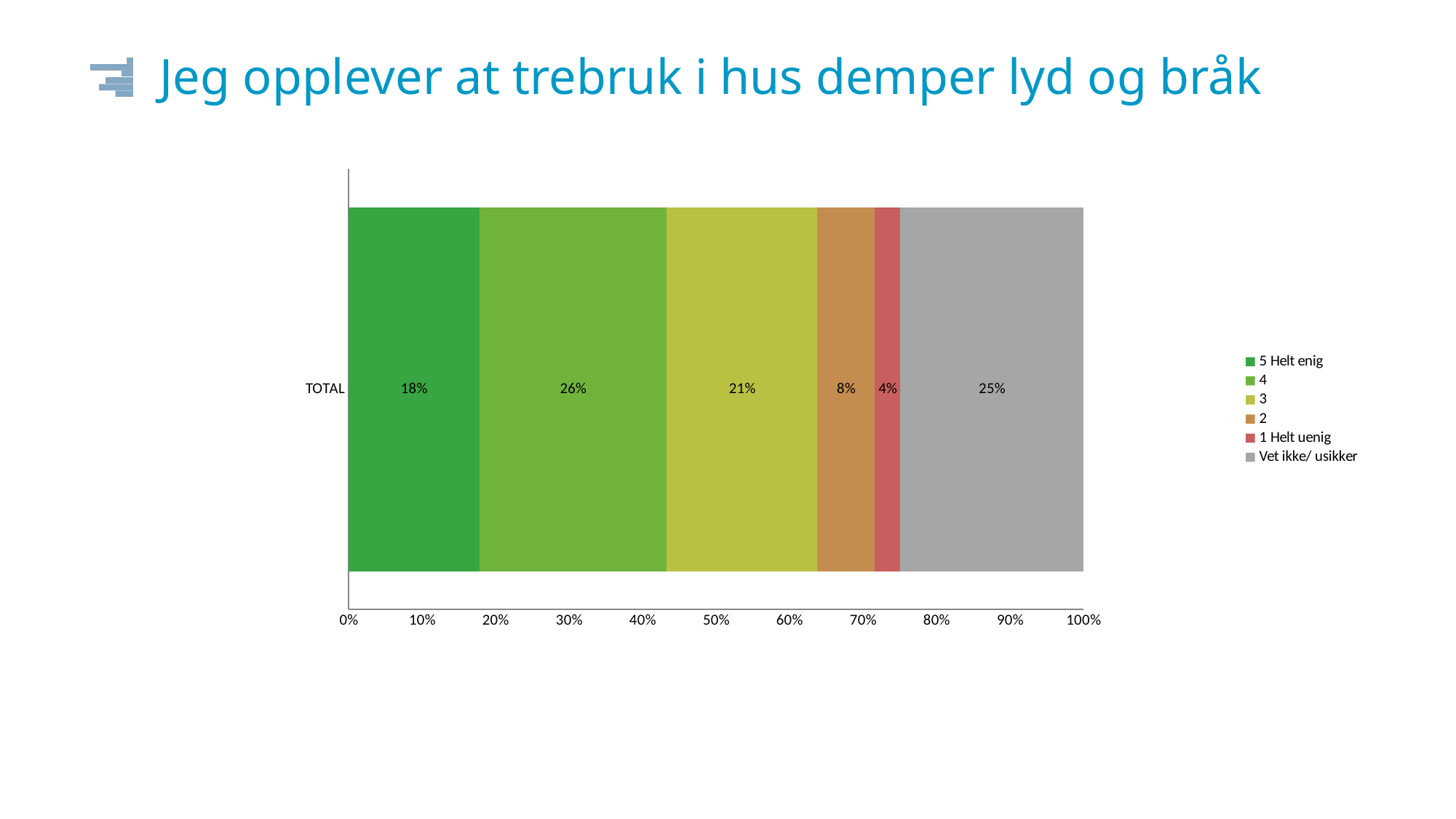
How many series does the legend list? 6 Which response category has the smallest share in the TOTAL bar? 1 Helt uenig What kind of chart is shown on the slide? Stacked bar chart What is the value for the "4" segment of the TOTAL bar? 26% What is the difference between the "4" segment and the "5 Helt enig" segment? 8% Which response category has the largest share in the TOTAL bar? 4 What colour is the "Vet ikke/ usikker" segment? Grey Which is larger, the "3" segment or the "2" segment? 3 What is the total of the TOTAL stacked bar? 102% What share of respondents answered "Vet ikke/ usikker"? 25% What percentage of respondents answered "5 Helt enig"? 18% What is the value for "1 Helt uenig"? 4%